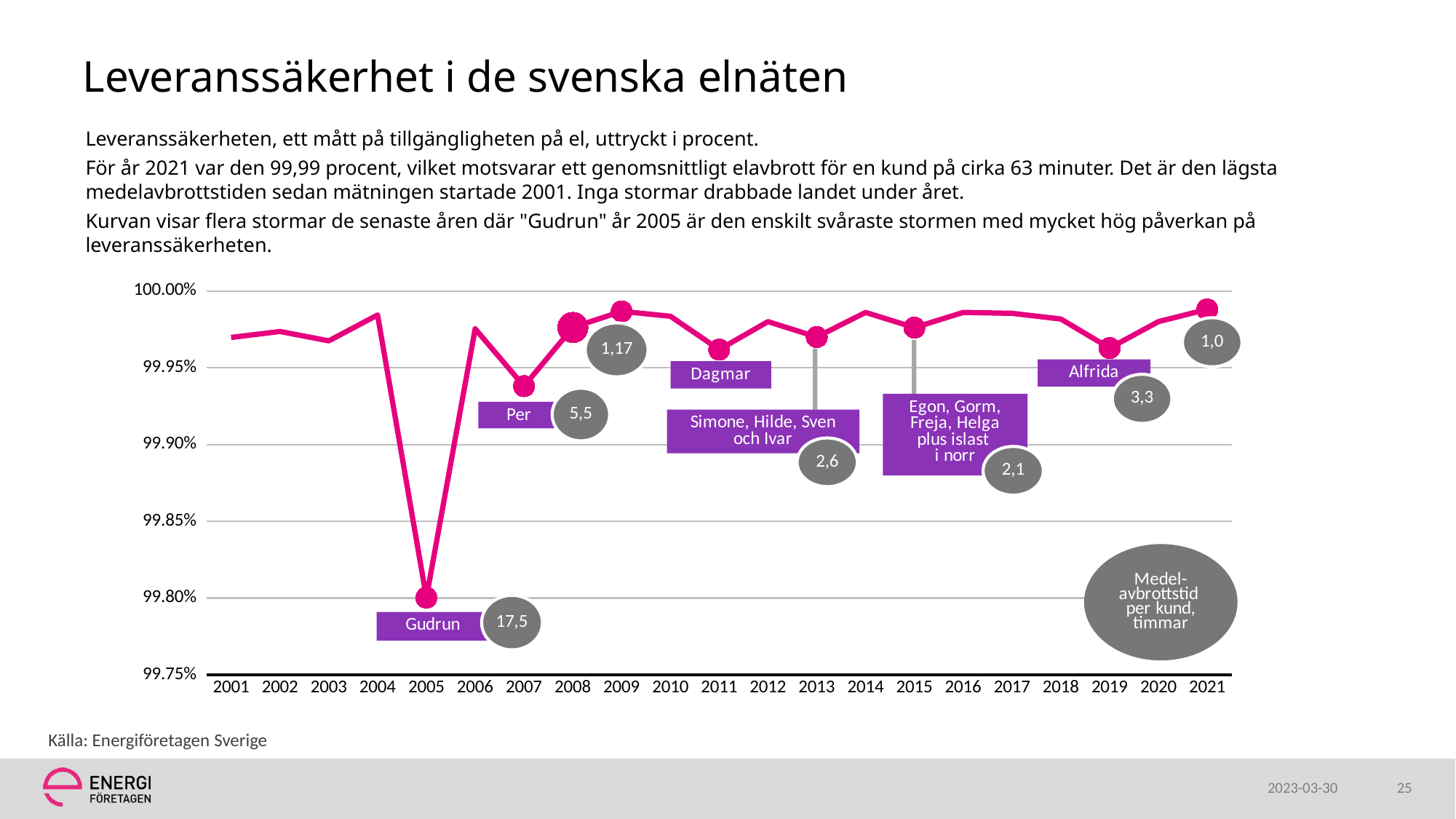
What average outage time per customer (hours) is shown for the storm Alfrida? 3,3 How many years are shown on the x axis of the chart? 21 In which year does the line reach its lowest point? 2005 Is the value for 2005 greater or less than 99.85%? less Which storm has the larger average outage time per customer, Gudrun or Per? Gudrun Is the value for 2009 greater or less than 99.95%? greater What average outage time per customer (hours) is shown for the storm Gudrun? 17,5 What is the difference in average outage time per customer (hours) between Gudrun and Per? 12,0 Is the value for 2019 greater or less than 99.90%? greater Which storm is labelled at the year 2019 on the chart? Alfrida What kind of chart is shown on the slide? line chart What average outage time per customer (hours) is shown for the storm Per? 5,5